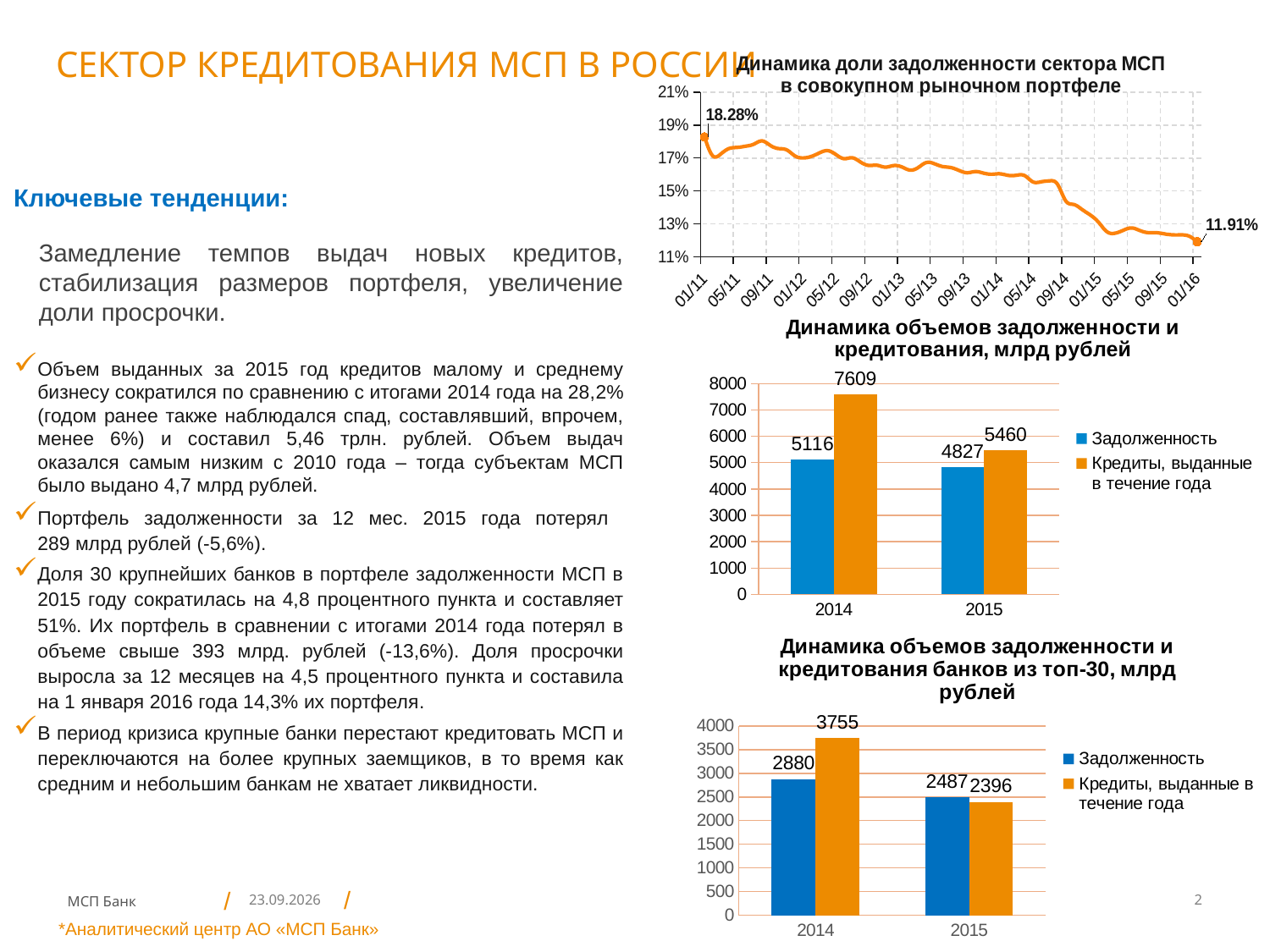
In the chart 'Динамика объемов задолженности и кредитования банков из топ-30, млрд рублей', what is the difference between Задолженность in 2014 and in 2015? 393 In the chart 'Динамика объемов задолженности и кредитования, млрд рублей', what is the value of 'Кредиты, выданные в течение года' for 2015? 5460 In the chart 'Динамика объемов задолженности и кредитования, млрд рублей', what is the value of Задолженность for 2014? 5116 In the chart 'Динамика доли задолженности сектора МСП в совокупном рыночном портфеле', what is the value labelled at the end of the line (01/16)? 11.91% In the chart 'Динамика объемов задолженности и кредитования банков из топ-30, млрд рублей', what is the value of Задолженность for 2015? 2487 How many series does the legend list in the chart 'Динамика объемов задолженности и кредитования банков из топ-30, млрд рублей'? 2 In the chart 'Динамика доли задолженности сектора МСП в совокупном рыночном портфеле', does the share rise or fall from 01/11 to 01/16? Fall In the chart 'Динамика объемов задолженности и кредитования банков из топ-30, млрд рублей', what is the value of 'Кредиты, выданные в течение года' for 2014? 3755 In the chart 'Динамика объемов задолженности и кредитования, млрд рублей', what is the difference between 'Кредиты, выданные в течение года' in 2014 and in 2015? 2149 In the chart 'Динамика объемов задолженности и кредитования, млрд рублей', which series has the higher value in 2015? Кредиты, выданные в течение года In the chart 'Динамика объемов задолженности и кредитования банков из топ-30, млрд рублей', which series has the higher value in 2015? Задолженность What type of chart is 'Динамика доли задолженности сектора МСП в совокупном рыночном портфеле'? Line chart